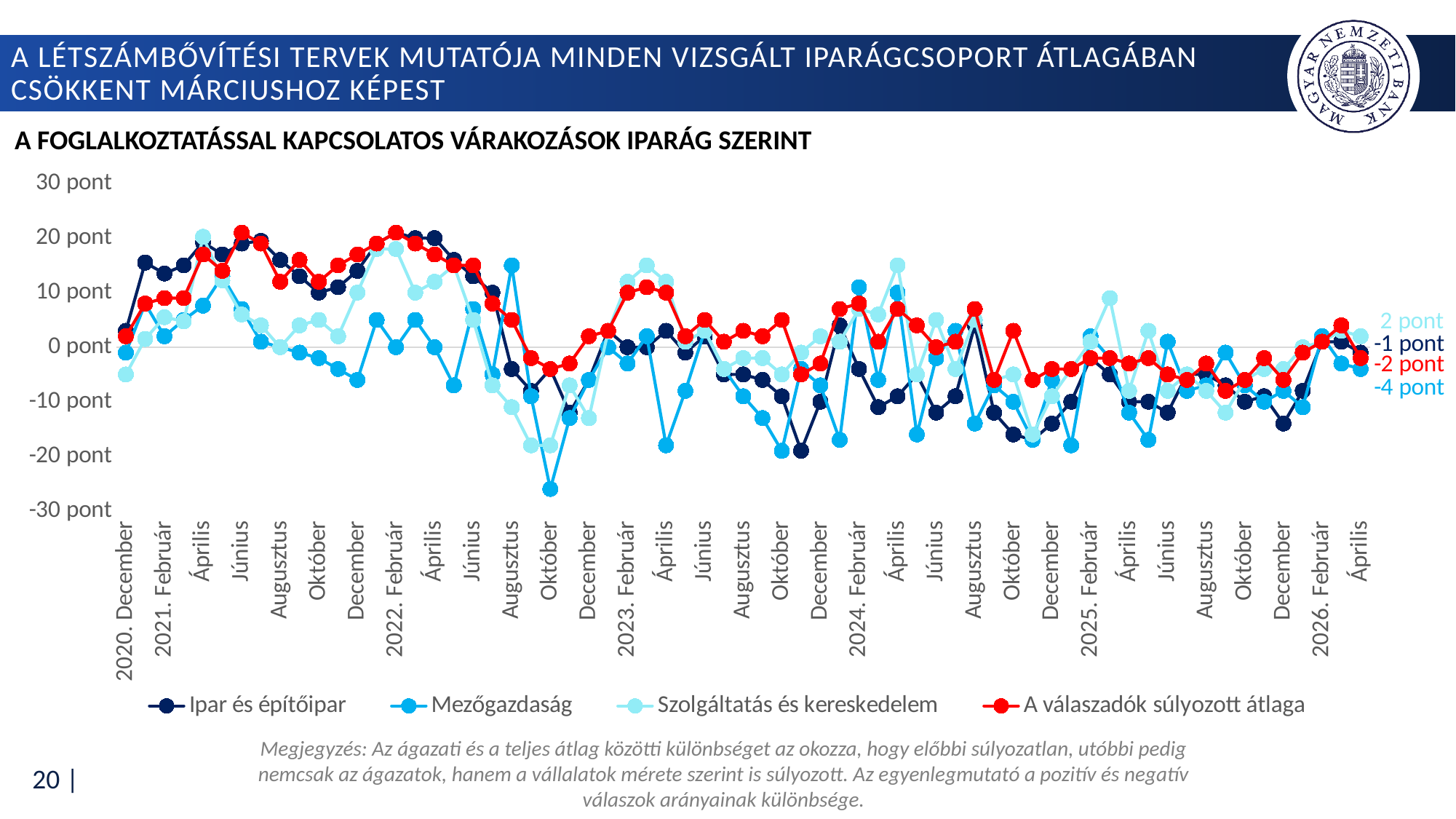
What is the latest (2026. Április) value shown for Szolgáltatás és kereskedelem? 2 pont At the last data point, which is larger: the value for Ipar és építőipar or the value for A válaszadók súlyozott átlaga? Ipar és építőipar What kind of chart is shown on the slide? line chart Which series has the lowest value at the last data point (2026. Április)? Mezőgazdaság Is the value for Mezőgazdaság in 2022 Október greater or less than -20 pont? less What is the difference between the latest values of Szolgáltatás és kereskedelem and Mezőgazdaság? 6 pont What is the latest (2026. Április) value shown for Ipar és építőipar? -1 pont What is the latest (2026. Április) value shown for A válaszadók súlyozott átlaga? -2 pont Which series has the highest value at the last data point (2026. Április)? Szolgáltatás és kereskedelem What is the latest (2026. Április) value shown for Mezőgazdaság? -4 pont How many series does the legend list? 4 What is the title of the chart? A foglalkoztatással kapcsolatos várakozások iparág szerint